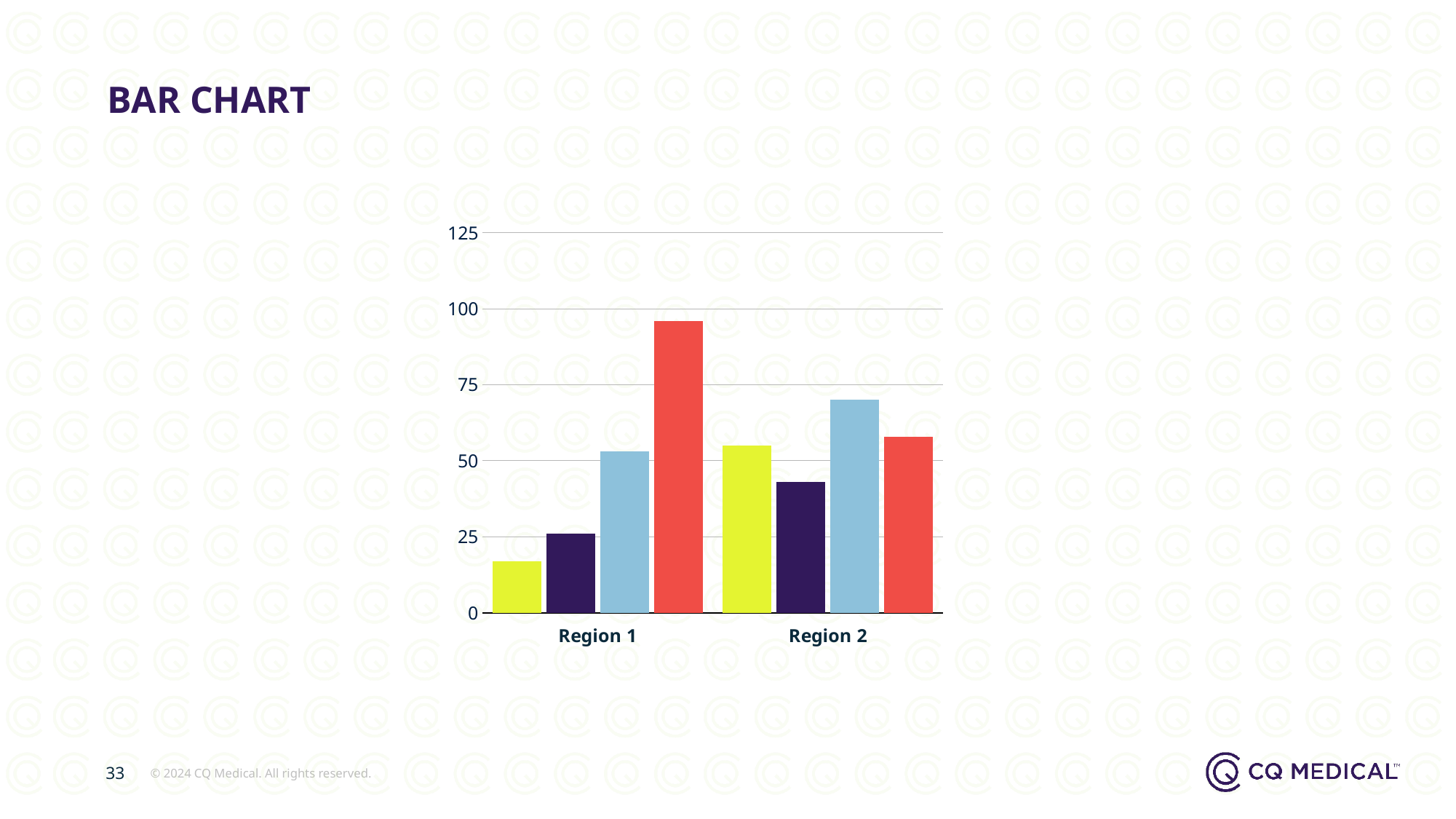
Is the value of the dark purple bar in Region 2 greater or less than 50? less Is the value of the yellow bar in Region 1 greater or less than 25? less What is the title of the slide containing the chart? BAR CHART Which coloured bar is the shortest in Region 2? Dark purple Which coloured bar is the tallest in Region 2? Light blue Which coloured bar is the tallest in Region 1? Red Which coloured bar is the shortest in Region 1? Yellow Is the value of the red bar in Region 1 greater or less than 75? greater How many categories are shown on the x axis of the chart? 2 How many bars are plotted for each region in the chart? 4 Which is larger: the red bar in Region 1 or the red bar in Region 2? Region 1 What kind of chart is shown on the slide? Bar chart